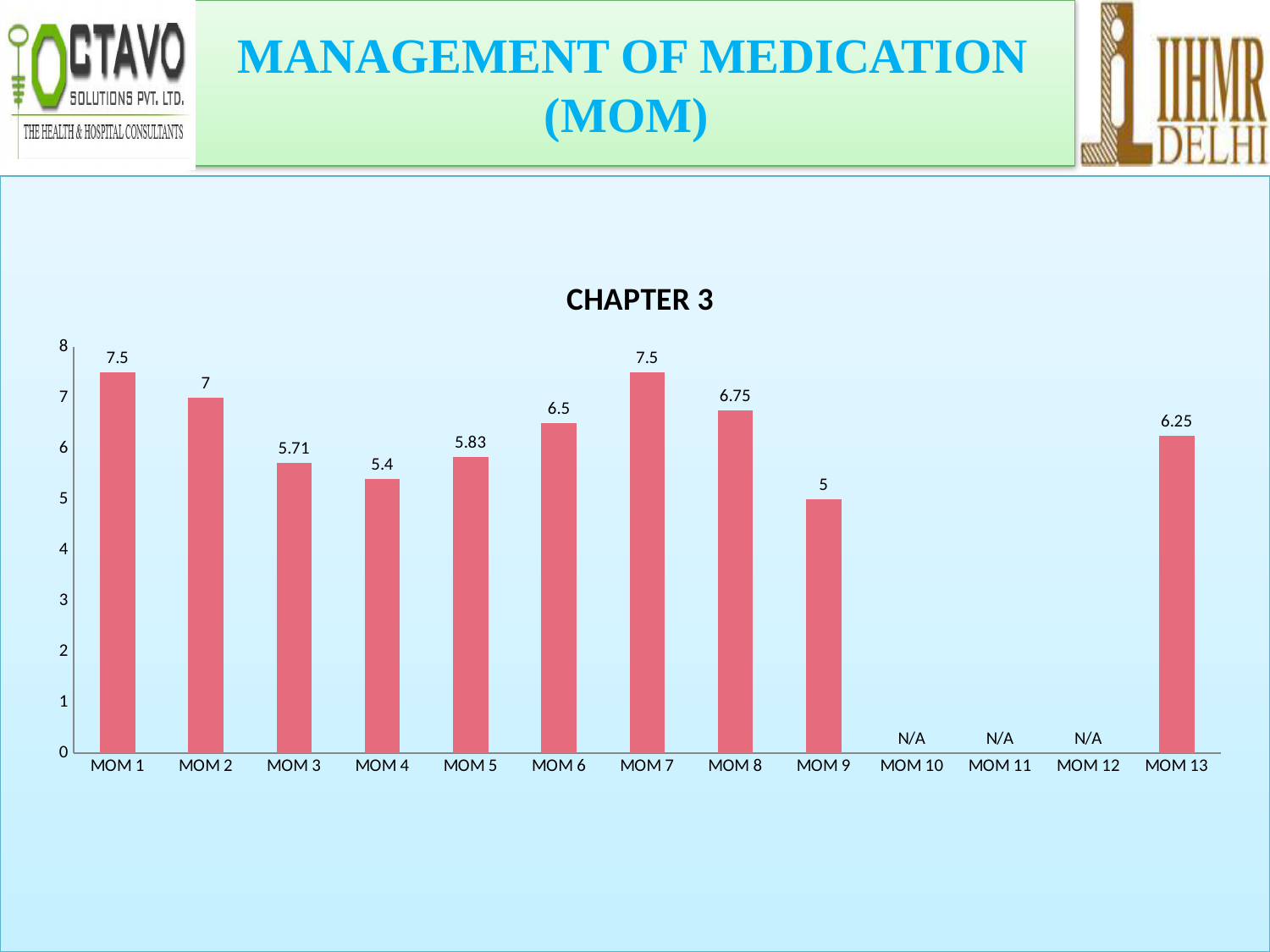
What is shown for MOM 11? N/A Which category has the lowest plotted value among those with a numeric value? MOM 9 What is the value for MOM 3? 5.71 What is the title of the chart? CHAPTER 3 What is the value for MOM 8? 6.75 How many categories are shown on the x axis? 13 What is the difference between the values for MOM 8 and MOM 4? 1.35 Which is larger, the value for MOM 2 or the value for MOM 6? MOM 2 What kind of chart is this? bar chart Is the value for MOM 5 greater or less than 6? less What is the value for MOM 13? 6.25 What is the difference between the values for MOM 1 and MOM 9? 2.5